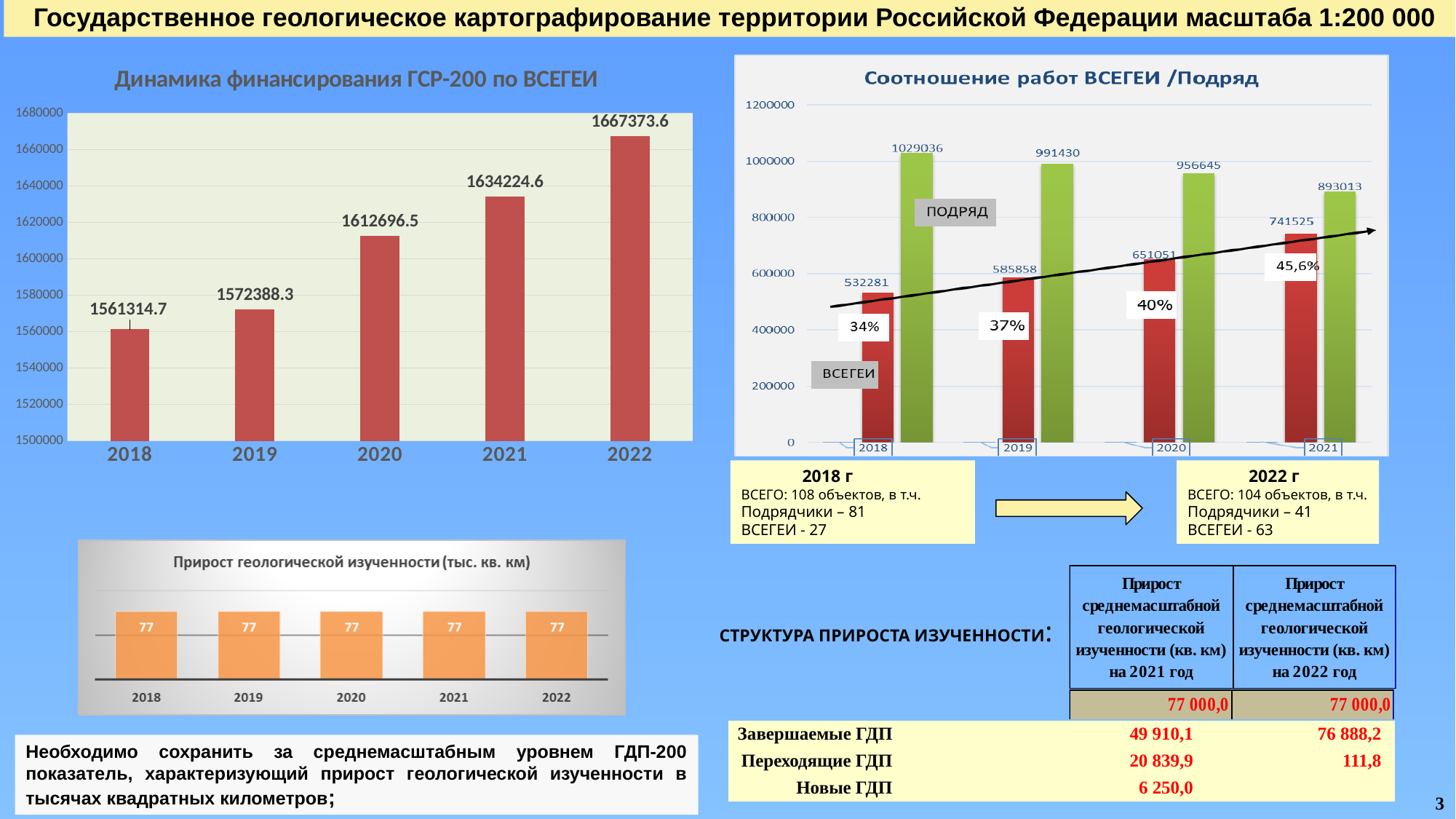
What type of chart is 'Прирост геологической изученности (тыс. кв. км)'? bar chart In the chart 'Соотношение работ ВСЕГЕИ /Подряд', what percentage label is shown for 2021? 45,6% In the chart 'Динамика финансирования ГСР-200 по ВСЕГЕИ', how many years are shown on the x axis? 5 In the chart 'Соотношение работ ВСЕГЕИ /Подряд', which is larger in 2020: ВСЕГЕИ or ПОДРЯД? ПОДРЯД In the chart 'Динамика финансирования ГСР-200 по ВСЕГЕИ', which year has the lowest value? 2018 In the chart 'Динамика финансирования ГСР-200 по ВСЕГЕИ', which year has the highest value? 2022 In the chart 'Динамика финансирования ГСР-200 по ВСЕГЕИ', do the values rise or fall from 2018 to 2022? rise In the chart 'Соотношение работ ВСЕГЕИ /Подряд', do the ПОДРЯД values rise or fall from 2018 to 2021? fall In the chart 'Динамика финансирования ГСР-200 по ВСЕГЕИ', what is the value for 2020? 1612696.5 In the chart 'Соотношение работ ВСЕГЕИ /Подряд', what is the ПОДРЯД value for 2019? 991430 In the chart 'Соотношение работ ВСЕГЕИ /Подряд', what is the difference between the ПОДРЯД and ВСЕГЕИ values in 2018? 496755 In the chart 'Соотношение работ ВСЕГЕИ /Подряд', what is the ВСЕГЕИ value for 2021? 741525